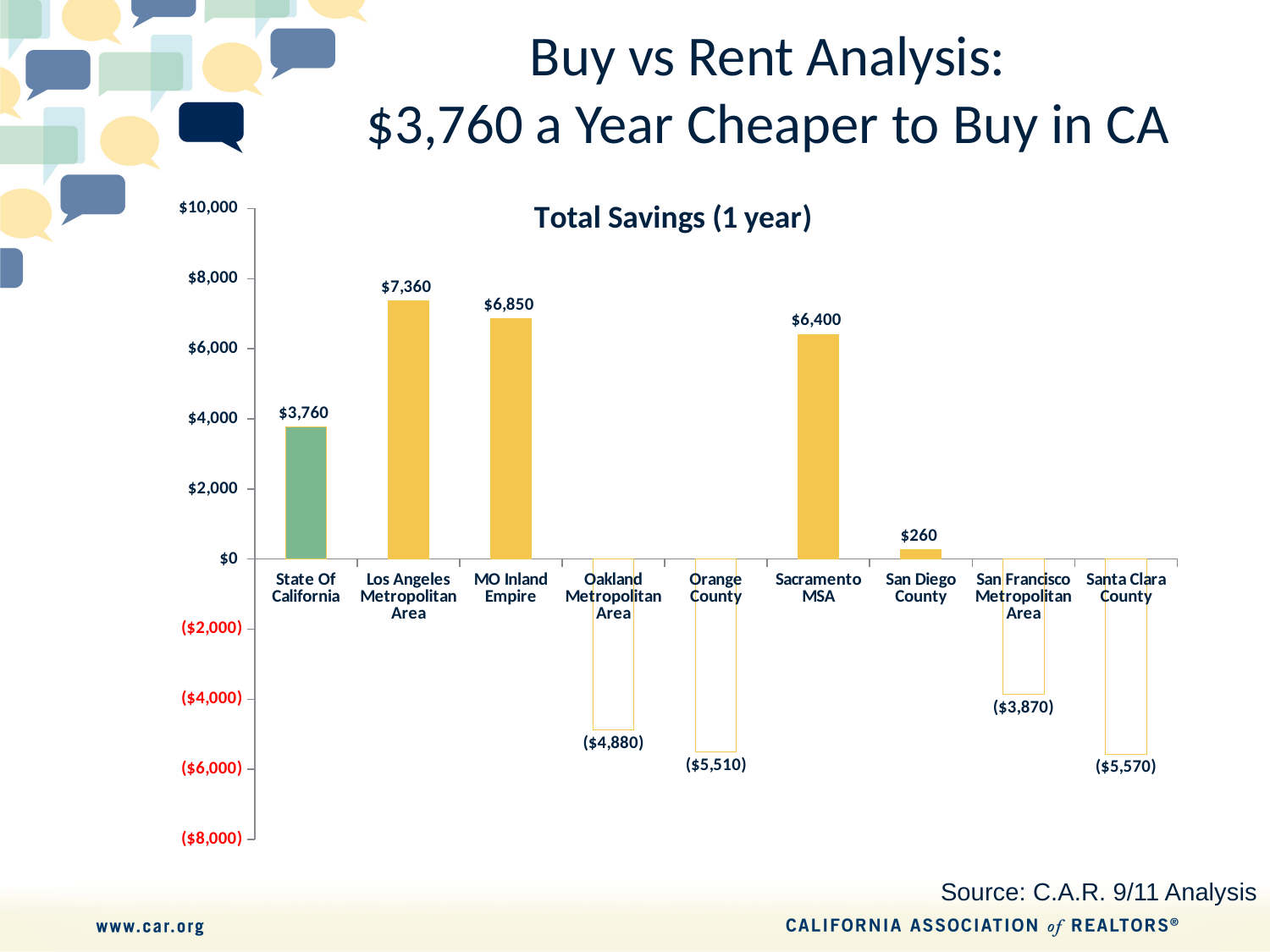
What is the Total Savings (1 year) value for the State Of California? $3,760 How many categories are shown on the Total Savings (1 year) chart? 9 Which category has the lowest Total Savings (1 year)? Santa Clara County What is the difference between the Total Savings (1 year) for the Los Angeles Metropolitan Area and the MO Inland Empire? $510 What kind of chart is used to show Total Savings (1 year)? Bar chart Is the Total Savings (1 year) value for Sacramento MSA greater or less than $6,000? greater What is the Total Savings (1 year) value for the Los Angeles Metropolitan Area? $7,360 Which category has the highest Total Savings (1 year)? Los Angeles Metropolitan Area What is the Total Savings (1 year) value for Santa Clara County? ($5,570) What is the Total Savings (1 year) value for San Diego County? $260 What is the title of the chart on the slide? Total Savings (1 year) Which has a larger Total Savings (1 year), Sacramento MSA or MO Inland Empire? MO Inland Empire